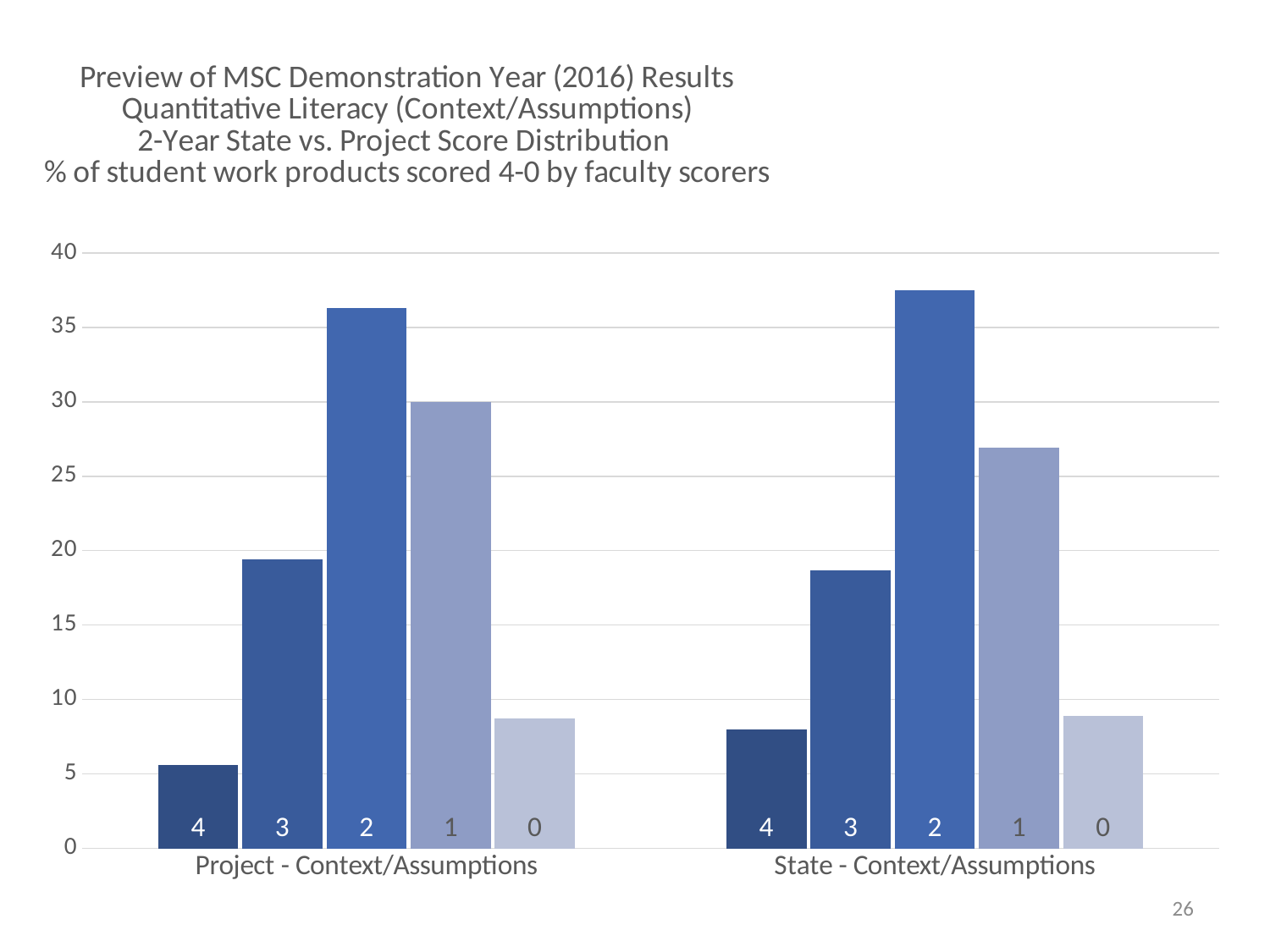
Is the value for score 4 in the Project - Context/Assumptions group greater or less than 10? less How many score levels (bars) are shown for each category? 5 In the State - Context/Assumptions group, which score has the tallest bar? 2 What kind of chart is shown on the slide? bar chart In the Project - Context/Assumptions group, which score has the shortest bar? 4 In the State - Context/Assumptions group, which score has the shortest bar? 4 Is the value for score 1 in the State - Context/Assumptions group greater or less than 25? greater How many categories are shown on the x axis? 2 Is the value for score 2 in the Project - Context/Assumptions group greater or less than 35? greater For score 4, which group has the larger value, Project - Context/Assumptions or State - Context/Assumptions? State - Context/Assumptions In the Project - Context/Assumptions group, which score has the tallest bar? 2 For score 1, which group has the larger value, Project - Context/Assumptions or State - Context/Assumptions? Project - Context/Assumptions